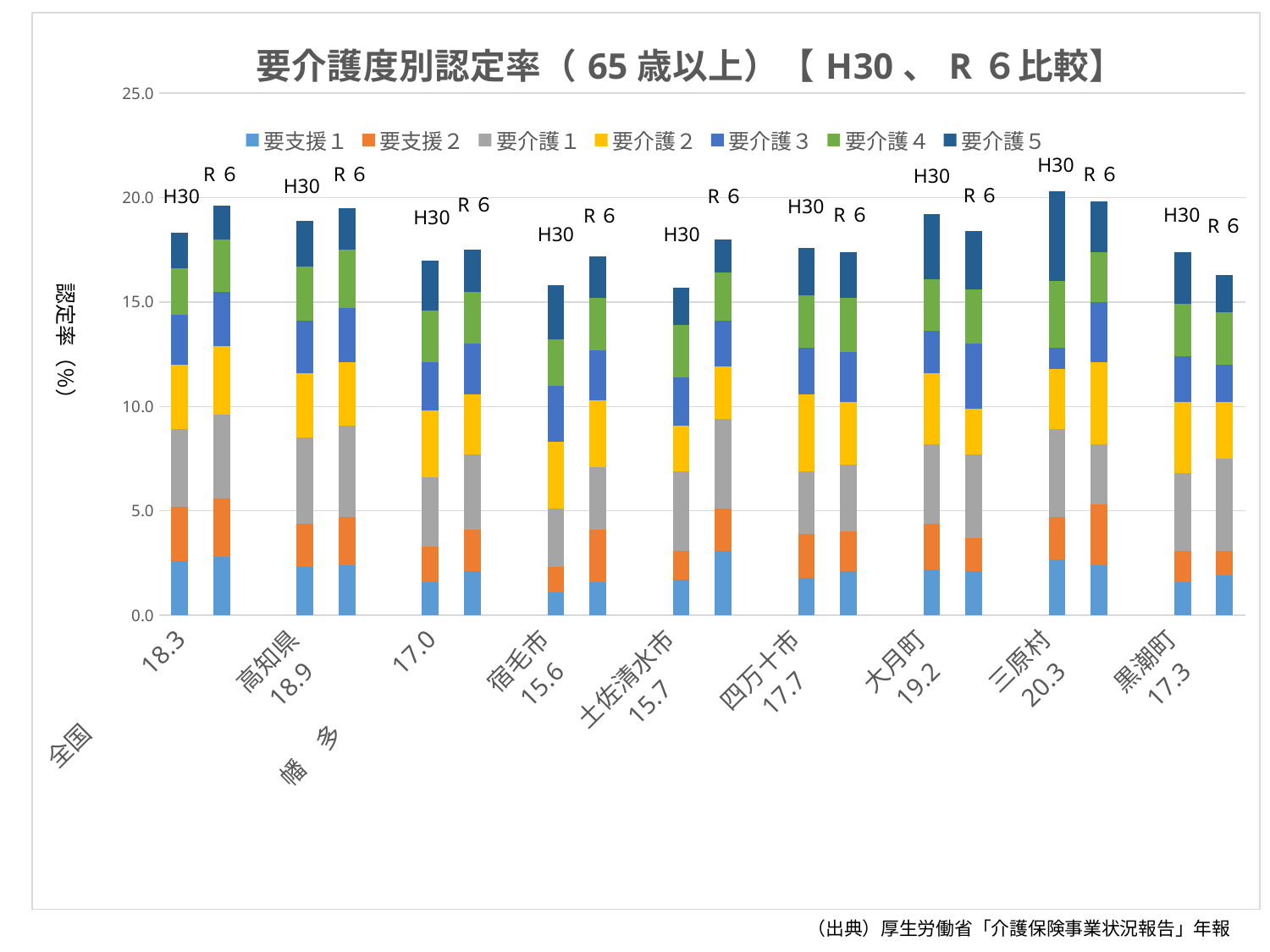
What is the first entry in the legend? 要支援１ What is the title of the chart? 要介護度別認定率（65歳以上）【H30、R6比較】 How many regions (categories) are shown along the x axis? 9 For 黒潮町, which bar is taller, H30 or R6? H30 How many series does the legend list? 7 What number is printed with the 宿毛市 category label? 15.6 What is the difference between the numbers printed with the 三原村 and 宿毛市 labels? 4.7 Among the R6 bars, which region has the lowest total? 黒潮町 Which bar is the tallest in the chart? 三原村 H30 What number is printed with the 三原村 category label? 20.3 What kind of chart is shown on the slide? stacked bar chart